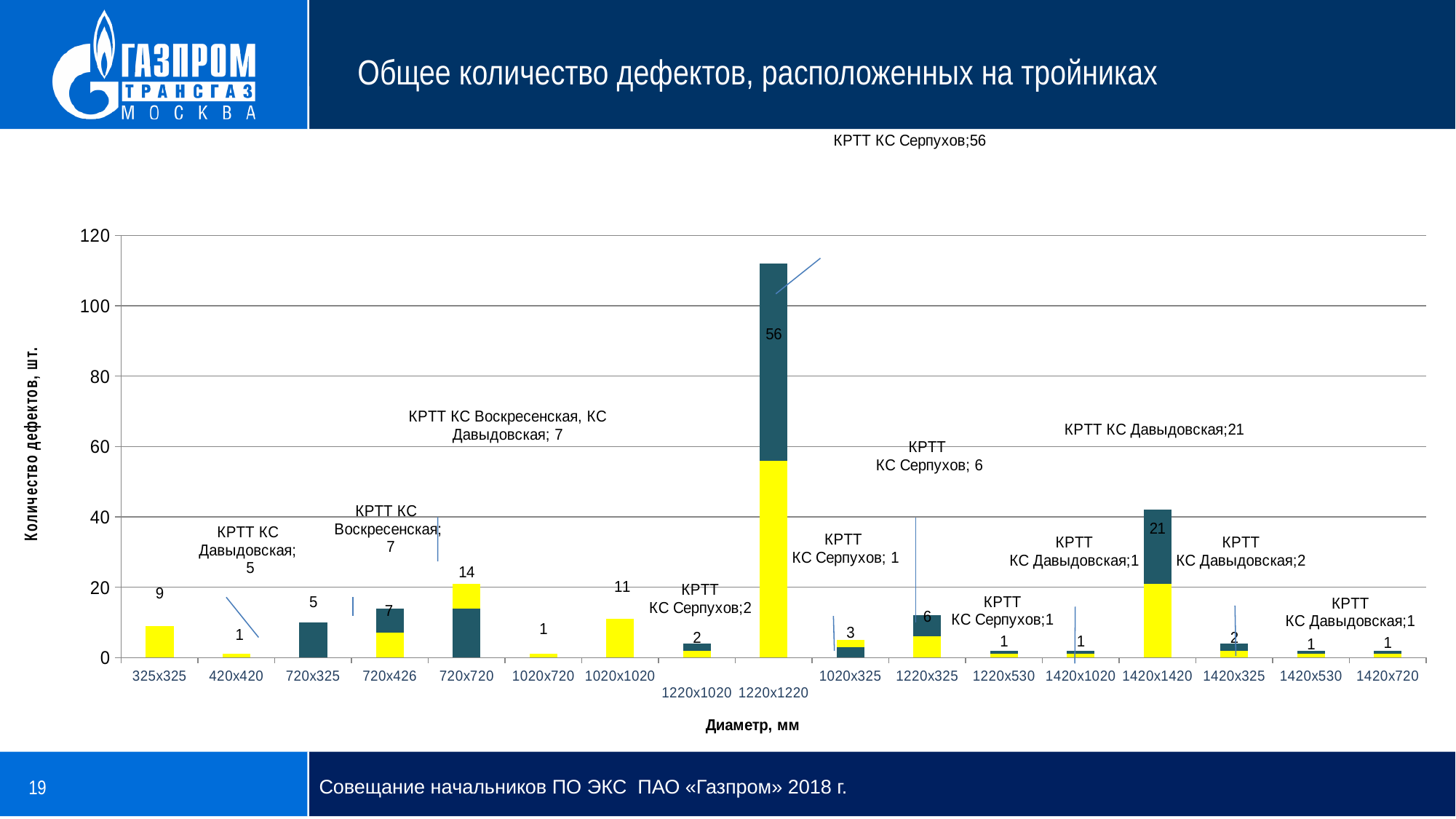
Which diameter category has the highest total number of defects? 1220x1220 What is the value labelled on the bar for 325x325? 9 What is the label of the vertical axis? Количество дефектов, шт. What kind of chart is shown on the slide? Bar chart (stacked) How many diameter categories are shown on the x axis? 17 Is the total for 1220x1220 greater or less than 100? greater What is the value labelled on the bar for 720x325? 5 What is the title of the chart? Общее количество дефектов, расположенных на тройниках What is the total height of the stacked bar for 1220x1220 (56 + 56)? 112 Which is larger, the value for 325x325 or the value for 1020x1020? 1020x1020 What is the value labelled on the bar for 1020x1020? 11 What is the difference between the value for 1020x1020 and the value for 325x325? 2